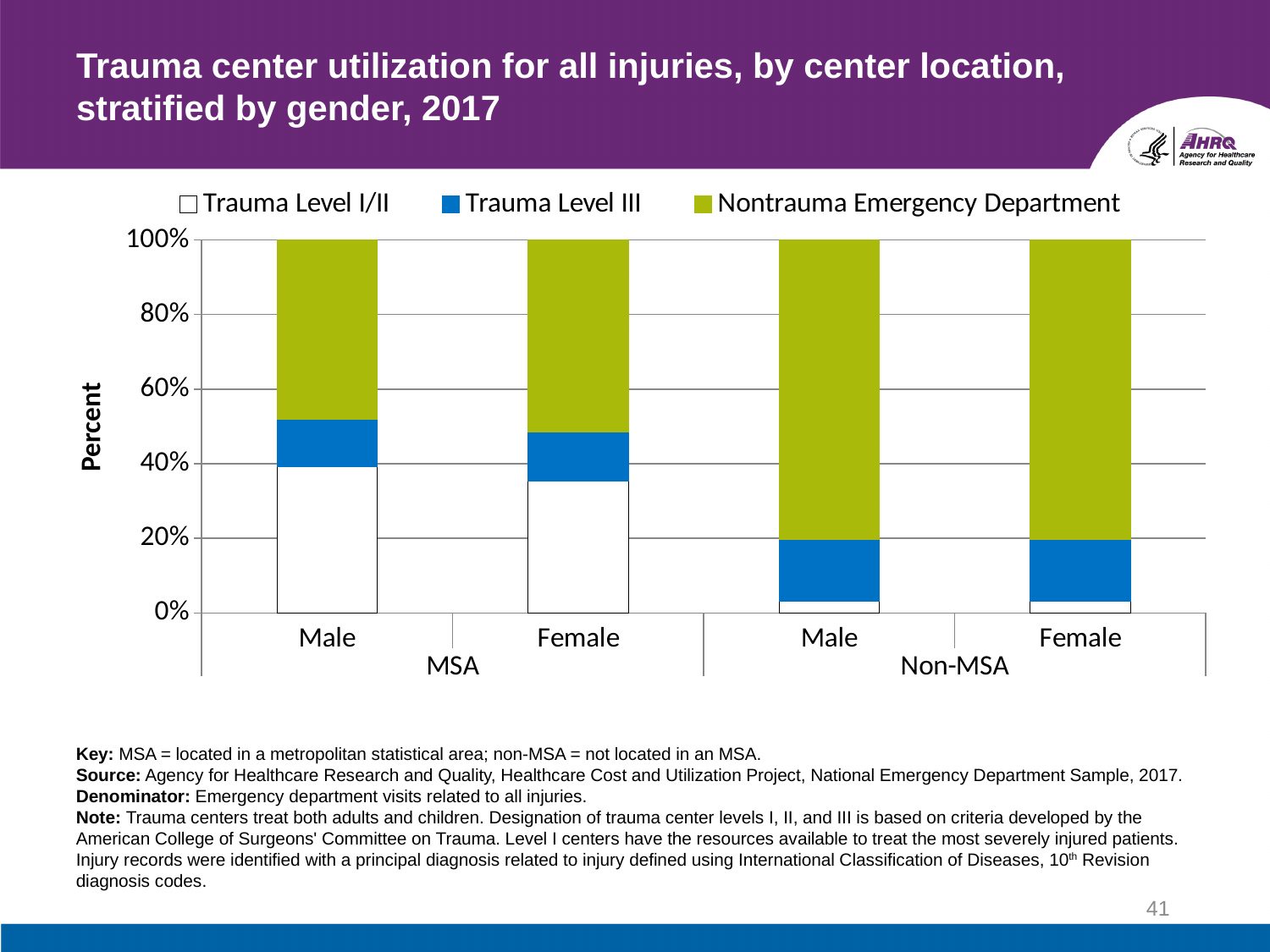
Is the Trauma Level I/II share for MSA Male greater or less than 20%? greater How many bars are plotted in the chart? 4 Which has the larger Nontrauma Emergency Department share, MSA Female or Non-MSA Female? Non-MSA Female What kind of chart is shown on the slide? Stacked bar chart Is the Trauma Level I/II share for Non-MSA Male greater or less than 20%? less Which has the larger Trauma Level I/II share, MSA Male or Non-MSA Male? MSA Male Which legend entry is shown in green? Nontrauma Emergency Department What does each stacked bar total? 100% What is the label on the vertical axis? Percent How many series does the legend list? 3 Is the Nontrauma Emergency Department share for MSA Male greater or less than 60%? less